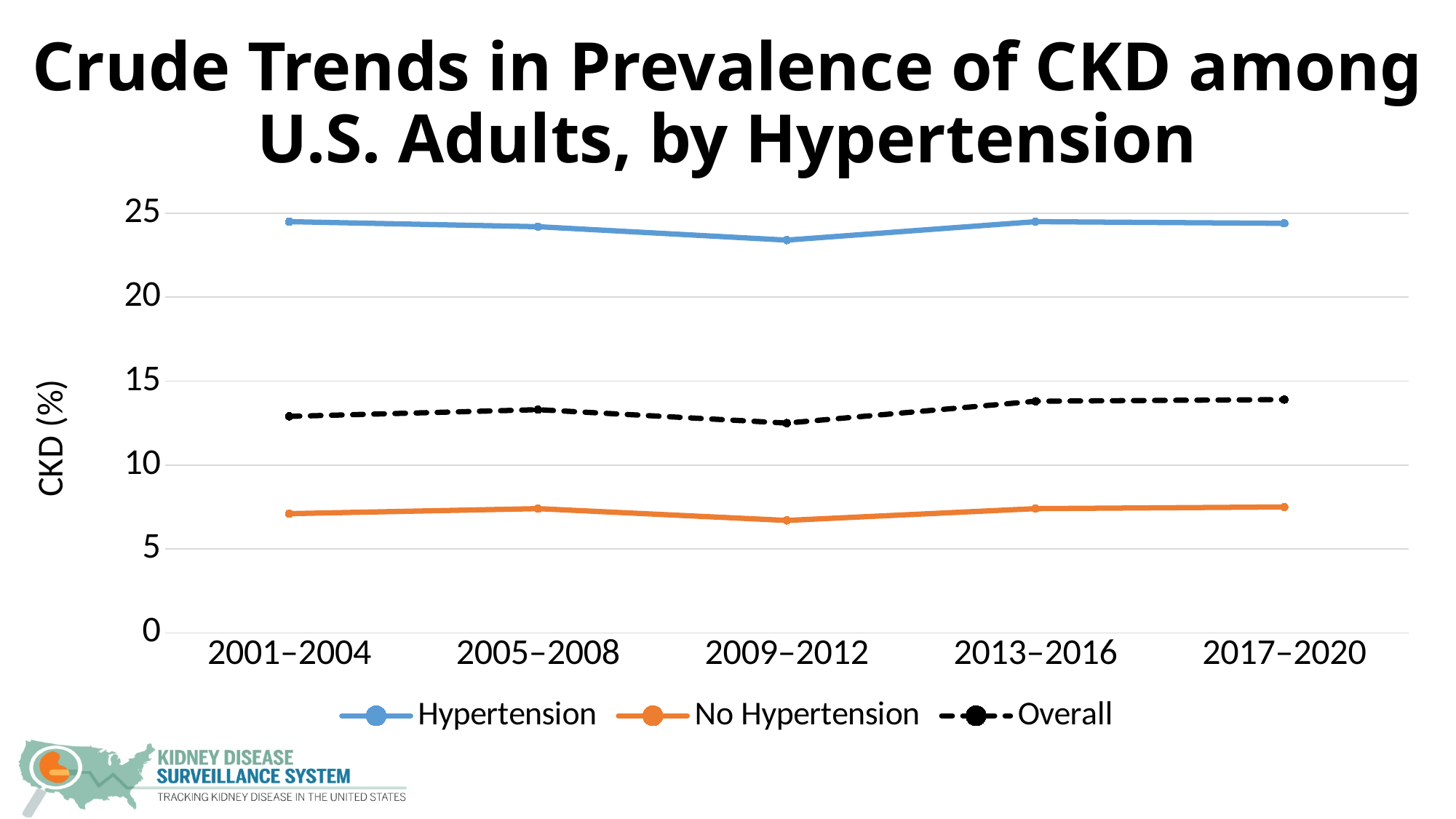
Which series has the higher value in 2017–2020, Hypertension or No Hypertension? Hypertension How many time periods are shown on the x axis? 5 Is the value for Overall in 2009–2012 greater or less than 10? greater Is the value for Hypertension in 2001–2004 greater or less than 20? greater Is the value for Overall in 2013–2016 greater or less than 15? less Does the Overall series rise or fall from 2009–2012 to 2013–2016? rise Which series is drawn with a dashed black line? Overall What kind of chart is shown on the slide? line chart In which period is the Hypertension series at its lowest? 2009–2012 How many series does the legend list? 3